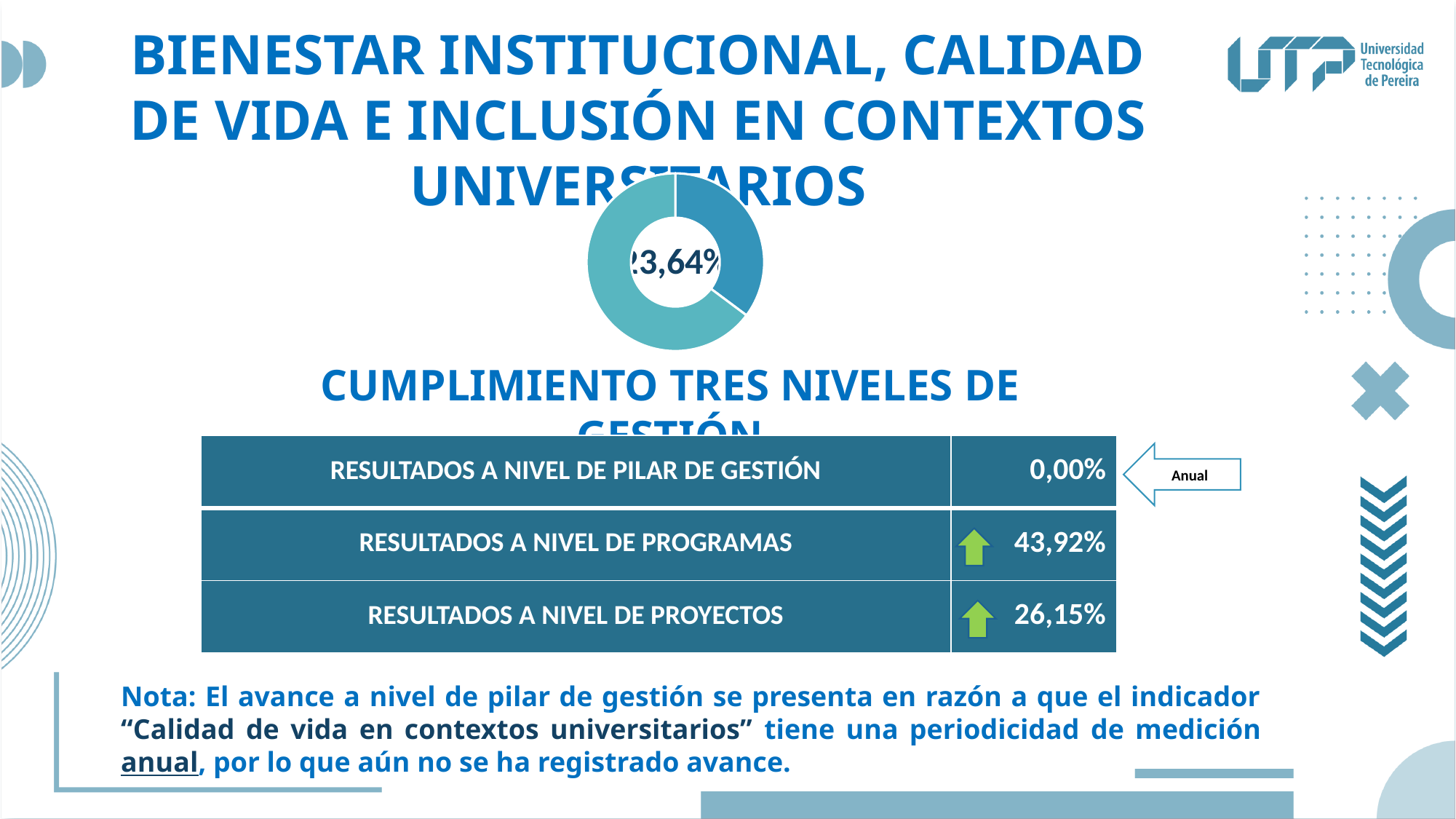
How many slices does the donut chart have? 2 What kind of chart is shown at the top of the slide? Donut (pie) chart Which slice of the donut chart is larger, the teal one or the dark blue one? The teal one What percentage is printed in the centre of the donut chart? 23,64% Is the dark blue slice of the donut chart greater or less than half of the ring? less What colour is the smaller slice of the donut chart? Dark blue Does the donut chart display a legend? No